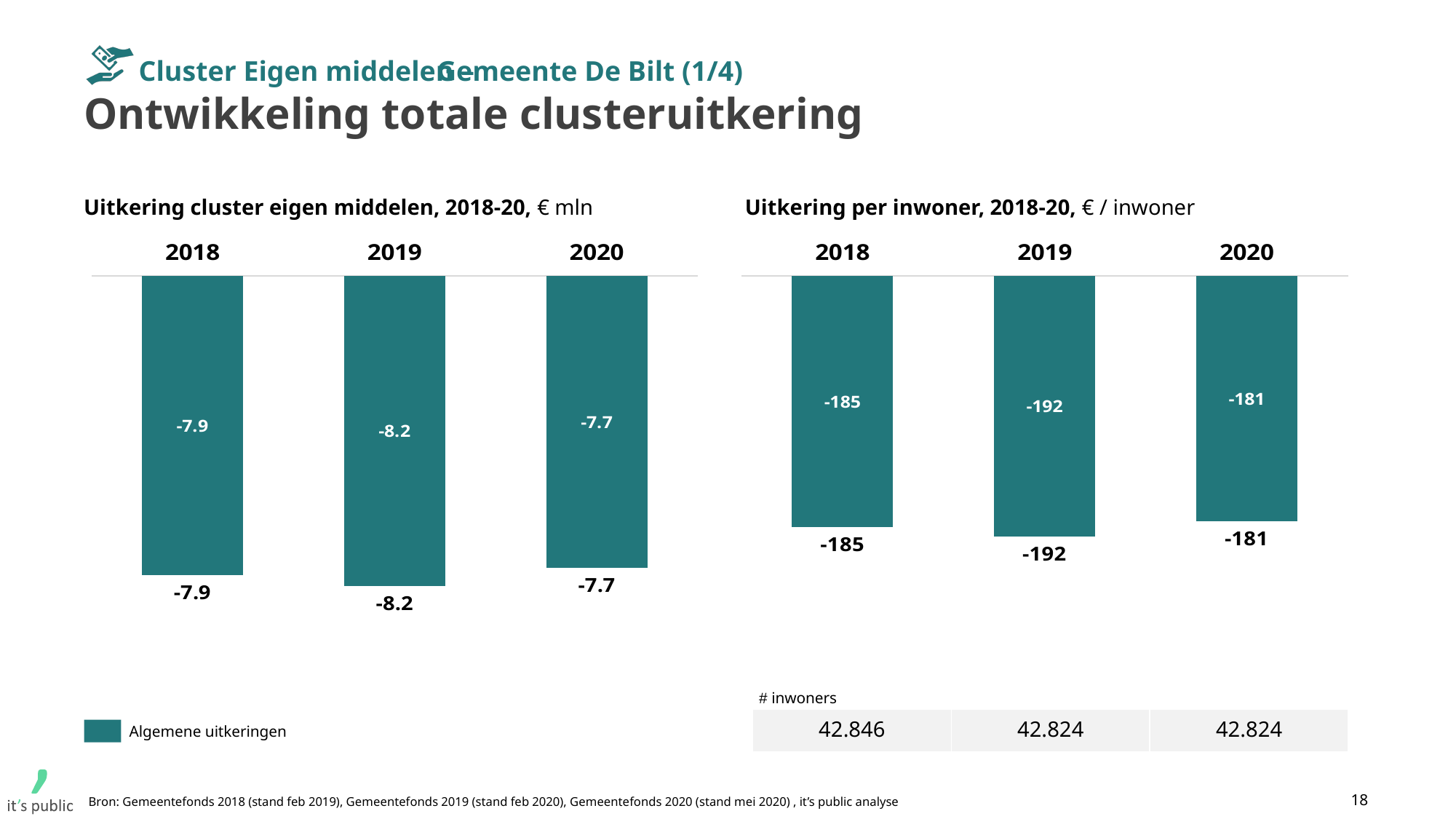
In the chart 'Uitkering cluster eigen middelen, 2018-20', what is the difference between the values for 2019 and 2020? 0.5 In the chart 'Uitkering cluster eigen middelen, 2018-20', what is the value for 2019? -8.2 In the chart 'Uitkering per inwoner, 2018-20', what is the difference between the values for 2019 and 2020? 11 What type of chart is 'Uitkering per inwoner, 2018-20'? bar chart How many years are shown in the chart 'Uitkering cluster eigen middelen, 2018-20'? 3 What is the legend entry shown below the chart 'Uitkering cluster eigen middelen, 2018-20'? Algemene uitkeringen In the chart 'Uitkering per inwoner, 2018-20', which year has the highest (least negative) value? 2020 In the chart 'Uitkering per inwoner, 2018-20', what is the value for 2018? -185 In the chart 'Uitkering per inwoner, 2018-20', what is the value for 2019? -192 In the chart 'Uitkering per inwoner, 2018-20', is the value for 2018 higher or lower than the value for 2019? higher In the chart 'Uitkering cluster eigen middelen, 2018-20', which year has the lowest (most negative) value? 2019 In the chart 'Uitkering cluster eigen middelen, 2018-20', what is the value for 2020? -7.7